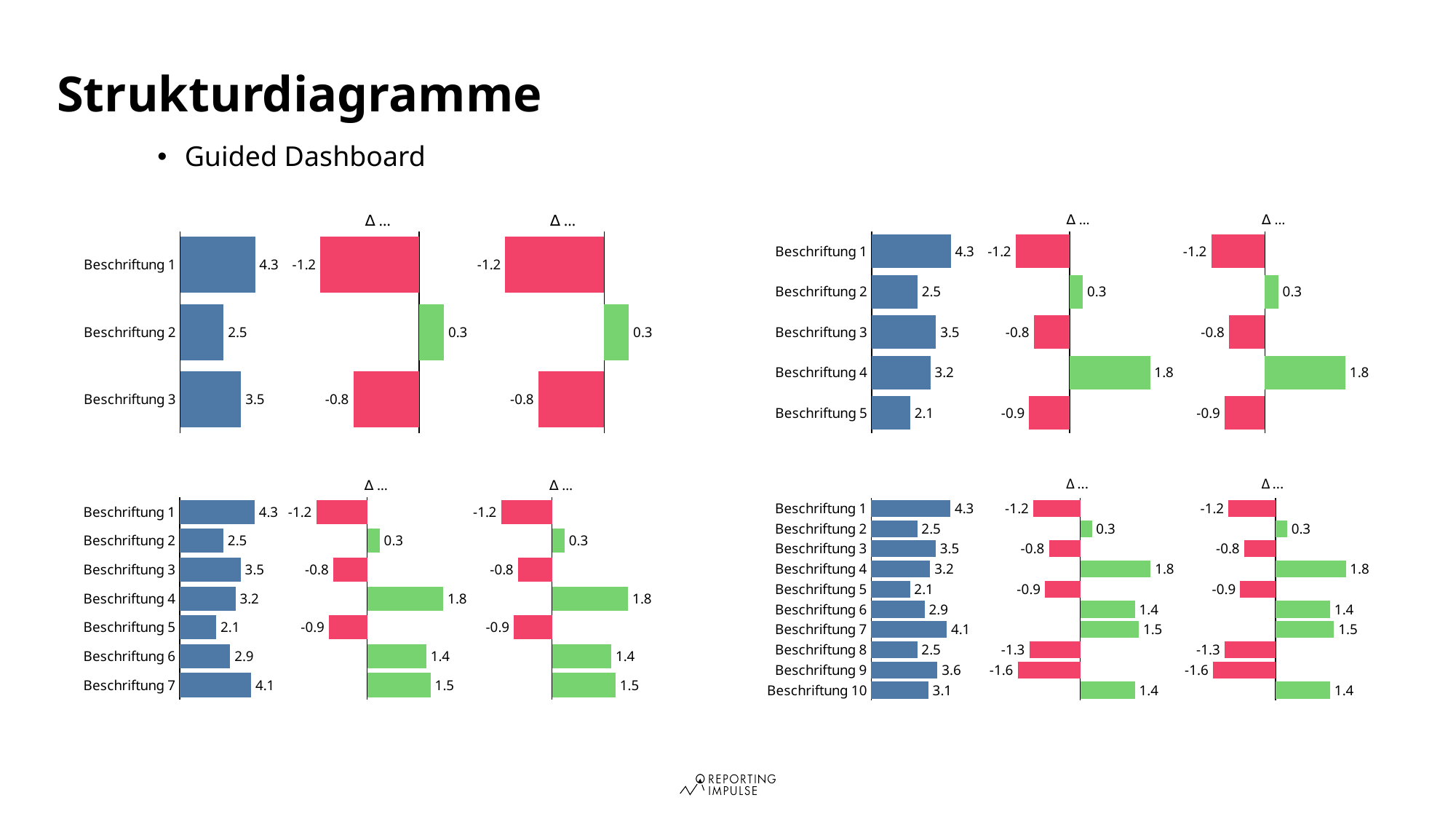
In the bottom-right chart, what is the value for Beschriftung 9 in the first Δ column? -1.6 In the top-left chart, how many categories are shown? 3 In the bottom-left chart, how many categories are shown? 7 In the bottom-left chart, what is the difference between the blue bar values for Beschriftung 7 and Beschriftung 6? 1.2 In the bottom-right chart, which category has the lowest value in the first Δ column? Beschriftung 9 In the bottom-right chart, is the blue bar value for Beschriftung 7 or Beschriftung 9 larger? Beschriftung 7 In the top-right chart, what is the value for Beschriftung 4 in the first Δ column? 1.8 In the top-left chart, what is the value for Beschriftung 3 in the blue bar series? 3.5 In the top-right chart, how many categories are shown? 5 What type of chart is used in the bottom-right chart? Bar chart In the bottom-left chart, which category has the lowest blue bar value? Beschriftung 5 In the top-right chart, which category has the highest blue bar value? Beschriftung 1